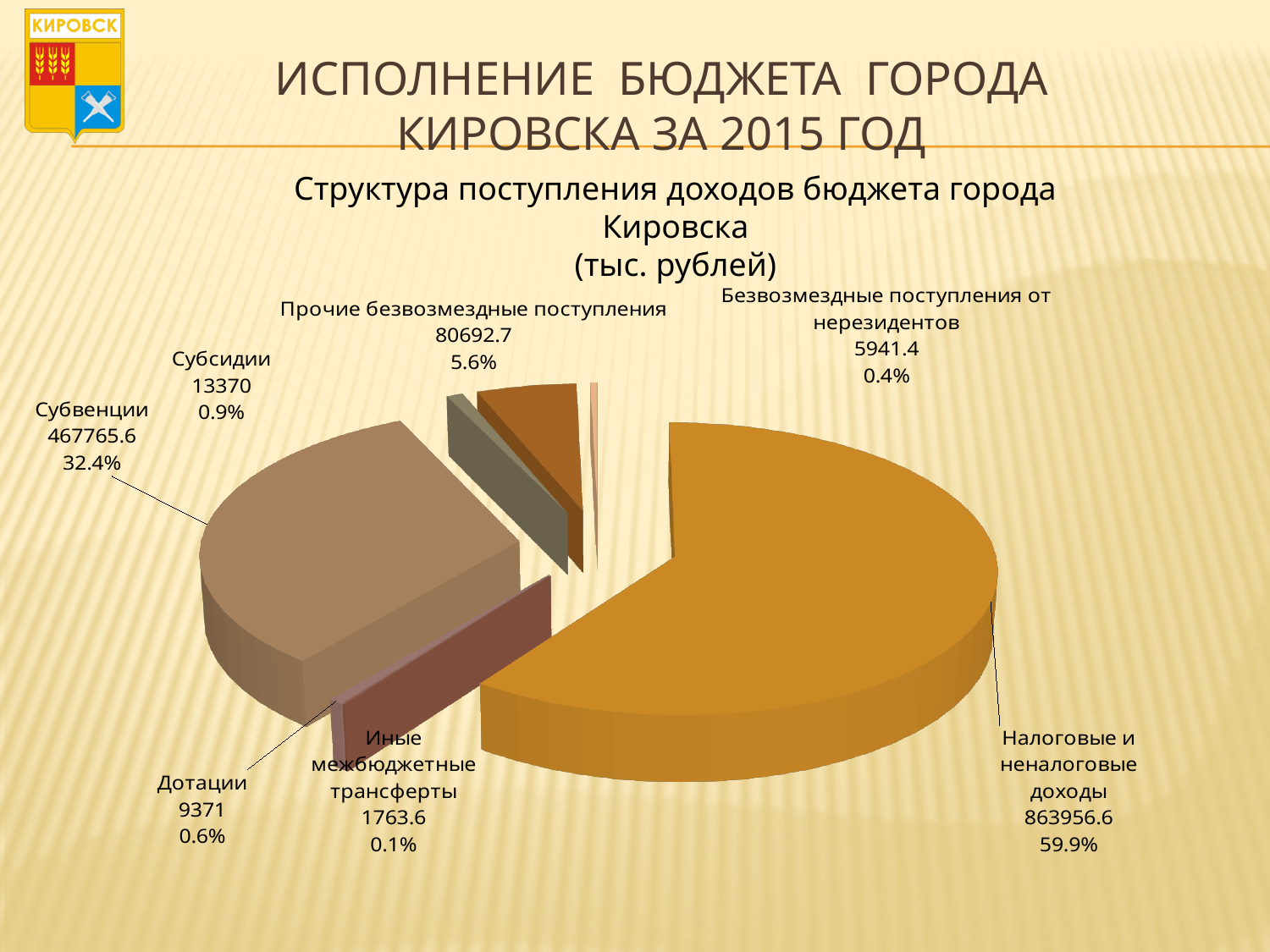
How many categories are shown in the pie chart? 7 What is the value for Налоговые и неналоговые доходы? 863956.6 What is the difference between the values for Субсидии and Дотации? 3999 What unit is stated in the chart title? тыс. рублей Which category has the smallest slice of the pie? Иные межбюджетные трансферты Which category has the largest slice of the pie? Налоговые и неналоговые доходы What is the value for Прочие безвозмездные поступления? 80692.7 Which is larger, the value for Субсидии or the value for Дотации? Субсидии What kind of chart is shown on the slide? Pie chart What is the value for Иные межбюджетные трансферты? 1763.6 What share of the pie does Субвенции represent? 32.4% What share of the pie does Безвозмездные поступления от нерезидентов represent? 0.4%